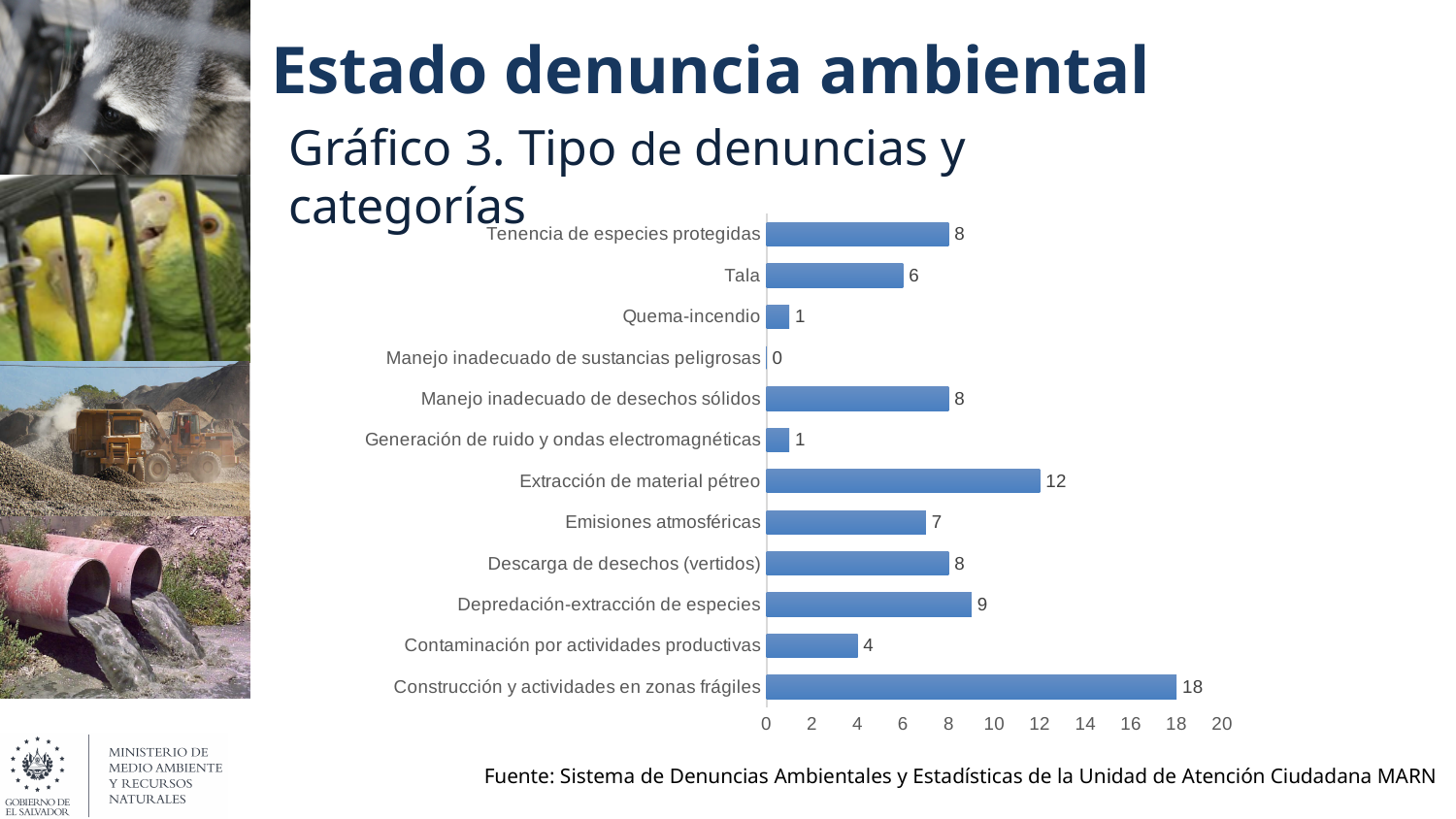
What is the value for Contaminación por actividades productivas? 4 How many categories are shown in the chart? 12 What is the value for Manejo inadecuado de sustancias peligrosas? 0 Which is larger, Depredación-extracción de especies or Emisiones atmosféricas? Depredación-extracción de especies What is the value for Construcción y actividades en zonas frágiles? 18 Which category has the highest value? Construcción y actividades en zonas frágiles What kind of chart is shown on the slide? Bar chart What is the difference between Construcción y actividades en zonas frágiles and Extracción de material pétreo? 6 Which category has the lowest value? Manejo inadecuado de sustancias peligrosas What is the value for Extracción de material pétreo? 12 What is the value for Tala? 6 What is the title of the chart? Gráfico 3. Tipo de denuncias y categorías